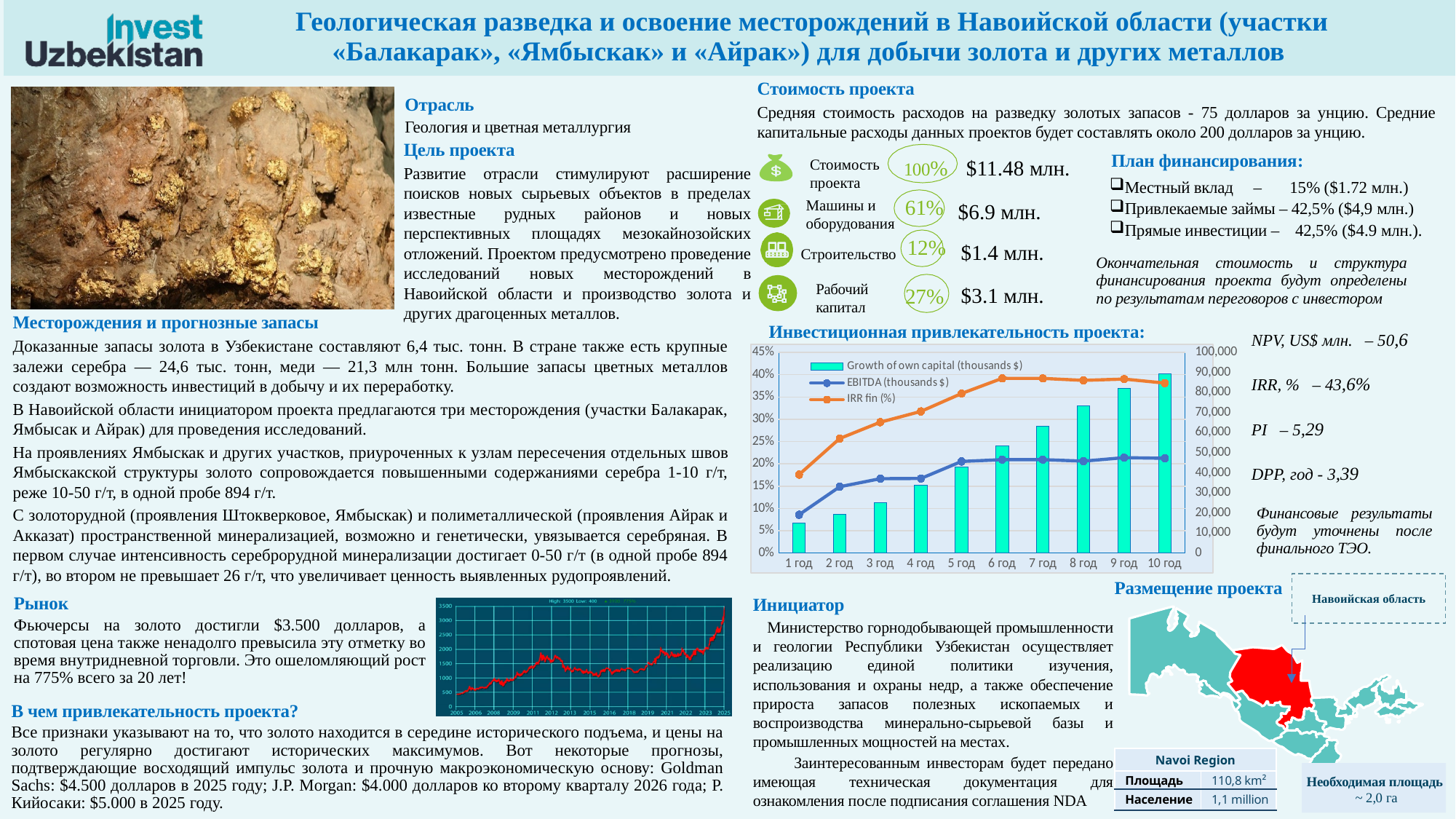
In the 'Инвестиционная привлекательность проекта' chart, is the 'Growth of own capital' bar for 10 год greater or less than 80,000 on the right axis? greater In the 'Инвестиционная привлекательность проекта' chart, which line is plotted higher at 5 год: 'IRR fin (%)' or 'EBITDA (thousands $)'? IRR fin (%) How many year categories are shown on the x axis of the 'Инвестиционная привлекательность проекта' chart? 10 In the 'Инвестиционная привлекательность проекта' chart, is the 'Growth of own capital' bar for 1 год greater or less than 20,000 on the right axis? less In the 'Инвестиционная привлекательность проекта' chart, which year has the shortest 'Growth of own capital' bar? 1 год In the 'Инвестиционная привлекательность проекта' chart, which year has the tallest 'Growth of own capital' bar? 10 год In the 'Инвестиционная привлекательность проекта' chart, is the 'IRR fin (%)' value for 6 год greater or less than 35%? greater How many series does the legend of the 'Инвестиционная привлекательность проекта' chart list? 3 What kind of chart is shown under 'Инвестиционная привлекательность проекта'? Combined bar and line chart In the 'Инвестиционная привлекательность проекта' chart, do the 'Growth of own capital' bars generally rise or fall from 1 год to 10 год? Rise In the 'Инвестиционная привлекательность проекта' chart, which series is shown with an orange line? IRR fin (%)